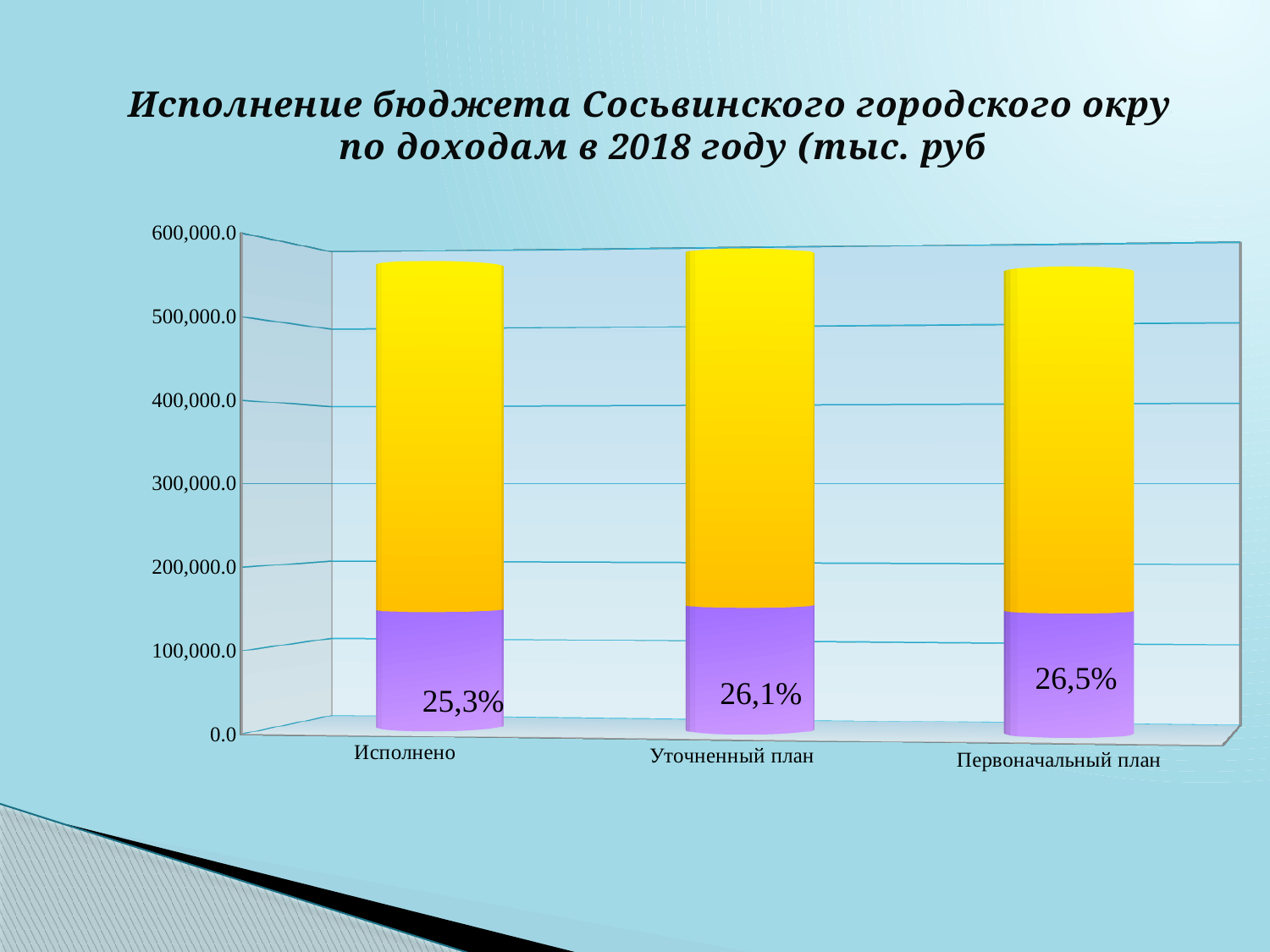
What percentage label is shown on the bar for Первоначальный план? 26,5% Is the total height of the bar for Уточненный план greater or less than 500,000.0? greater Which category has the highest percentage label? Первоначальный план Is the purple (lower) segment of the bar for Исполнено greater or less than 200,000.0? less Which category has the tallest bar overall? Уточненный план How many categories are shown along the x axis of the chart? 3 What year does the chart title say the budget execution refers to? 2018 What percentage label is shown on the bar for Исполнено? 25,3% What percentage label is shown on the bar for Уточненный план? 26,1% Which has the larger percentage label, Уточненный план or Исполнено? Уточненный план Which category has the lowest percentage label? Исполнено What kind of chart is shown on the slide? bar chart